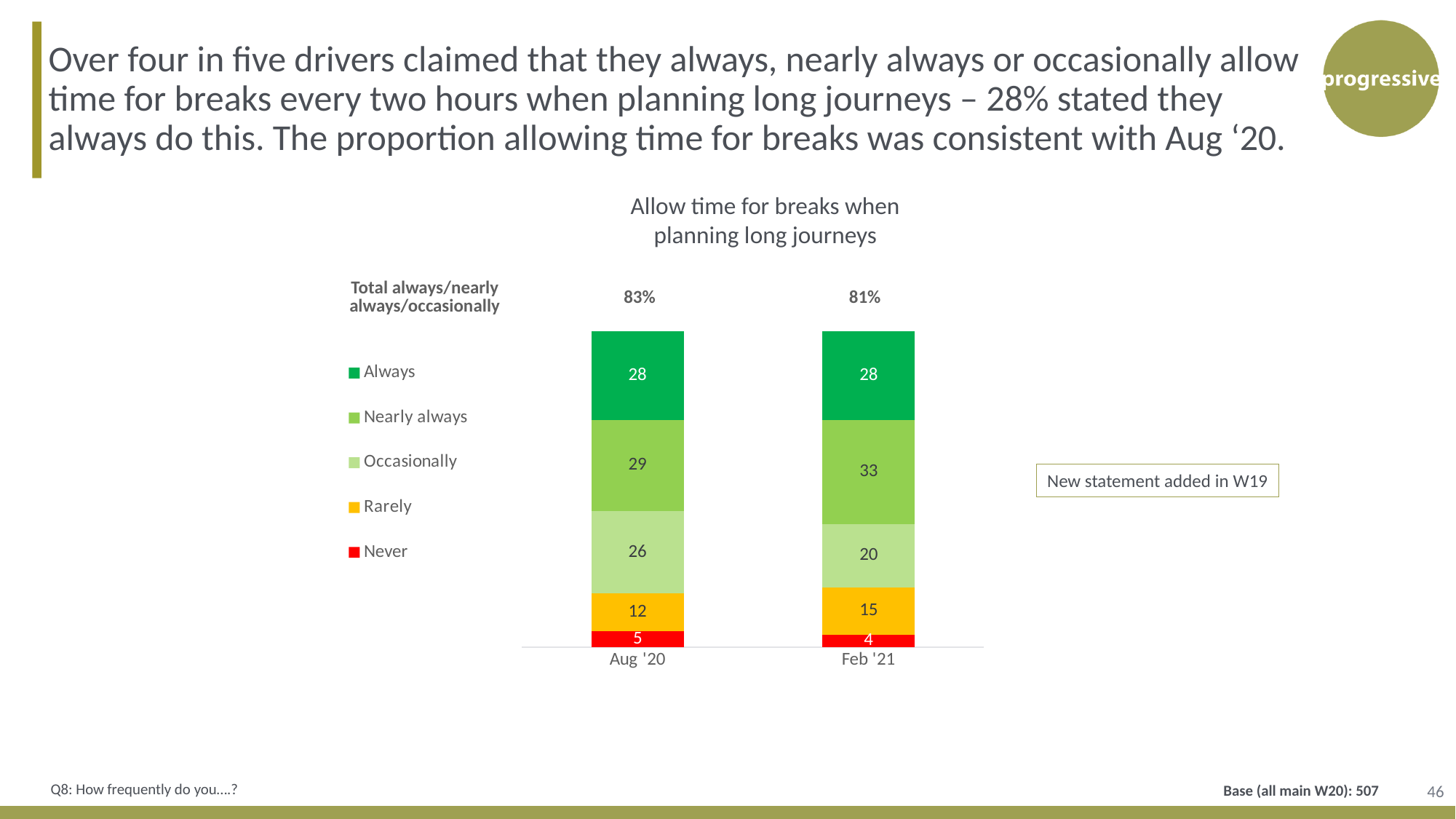
How many bars are plotted in the chart? 2 What is the value for Never in Feb '21? 4 What type of chart is shown? Stacked bar chart Which is larger, the Rarely value in Aug '20 or in Feb '21? Feb '21 How many series does the legend list? 5 What is the value for Nearly always in Feb '21? 33 Which segment is the smallest in the Aug '20 bar? Never What is the value for Occasionally in Aug '20? 26 What is the value for Rarely in Aug '20? 12 What is the total always/nearly always/occasionally figure shown for Feb '21? 81% What is the difference between the Occasionally values for Aug '20 and Feb '21? 6 Which segment is the largest in the Feb '21 bar? Nearly always